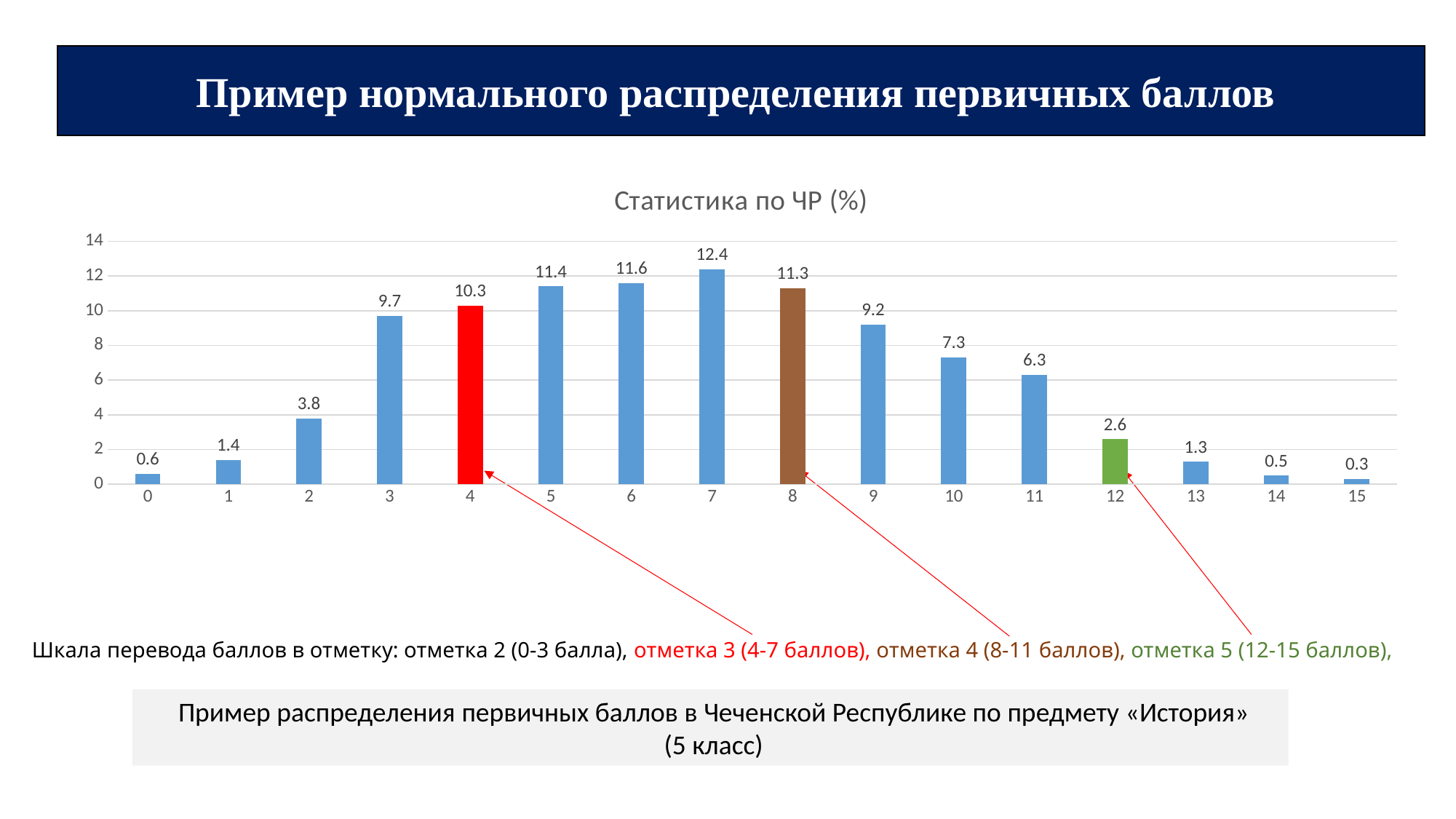
What is the value for score 3? 9.7 What is the value for score 7? 12.4 Which score has the lowest value? 15 Which score has the highest value? 7 What kind of chart is shown? bar chart What is the difference between the values for score 7 and score 8? 1.1 Which is larger, the value for score 4 or the value for score 9? score 4 What is the title of the chart? Статистика по ЧР (%) What is the value for score 12? 2.6 How many score categories are shown on the x axis? 16 Is the value for score 10 greater or less than 8? less Do the values rise or fall from score 8 to score 15? fall